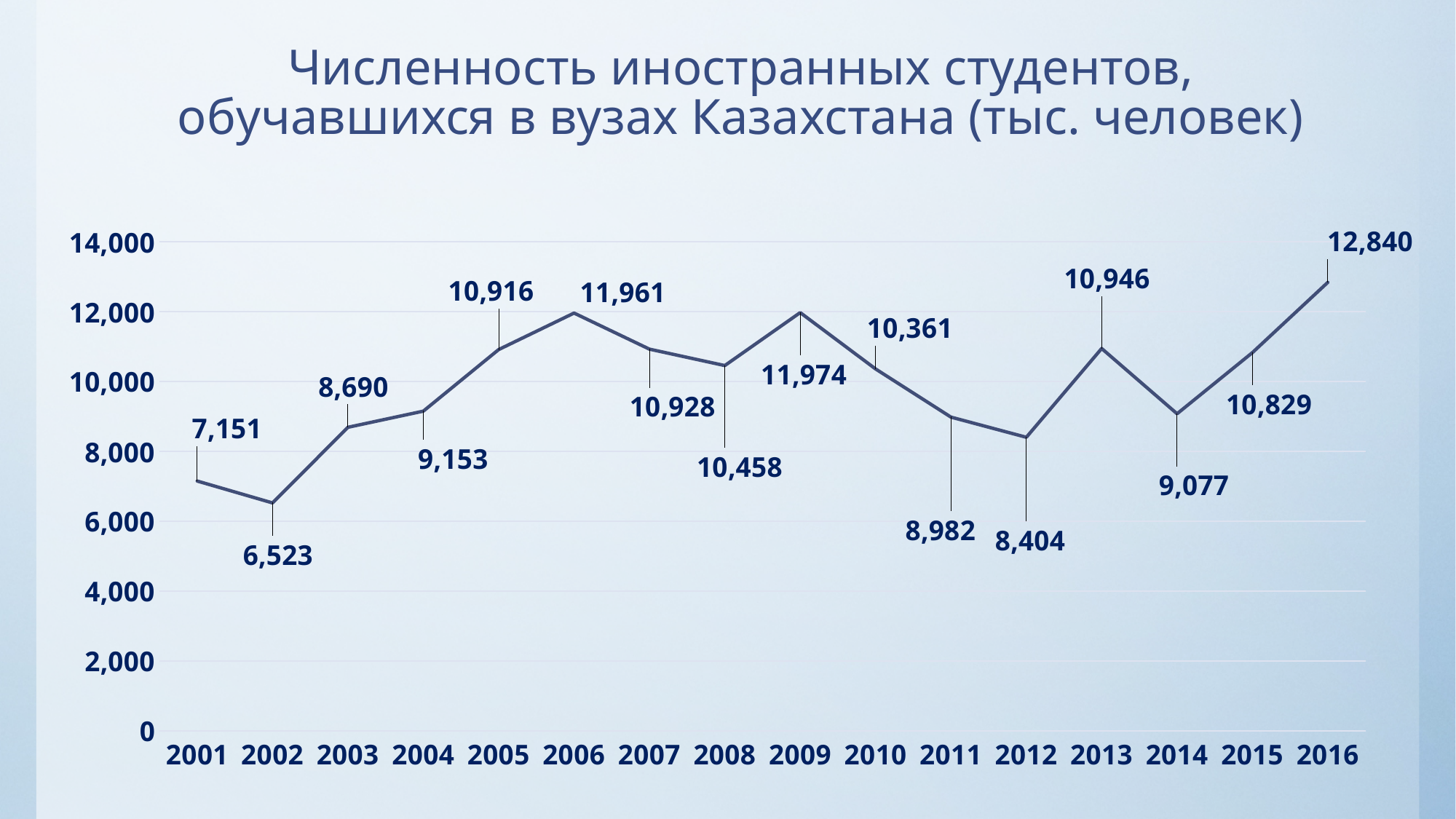
Which is larger, the value for 2003 or the value for 2005? 2005 Do the values rise or fall from 2009 to 2012? fall Is the value for 2005 greater or less than 10,000? greater What is the value for 2001? 7,151 What is the value for 2014? 9,077 What is the difference between the values for 2013 and 2012? 2,542 Which year has the lowest value? 2002 Which year has the highest value? 2016 What kind of chart is shown on the slide? line chart How many years are plotted on the x axis? 16 What is the value for 2009? 11,974 What is the difference between the values for 2016 and 2001? 5,689